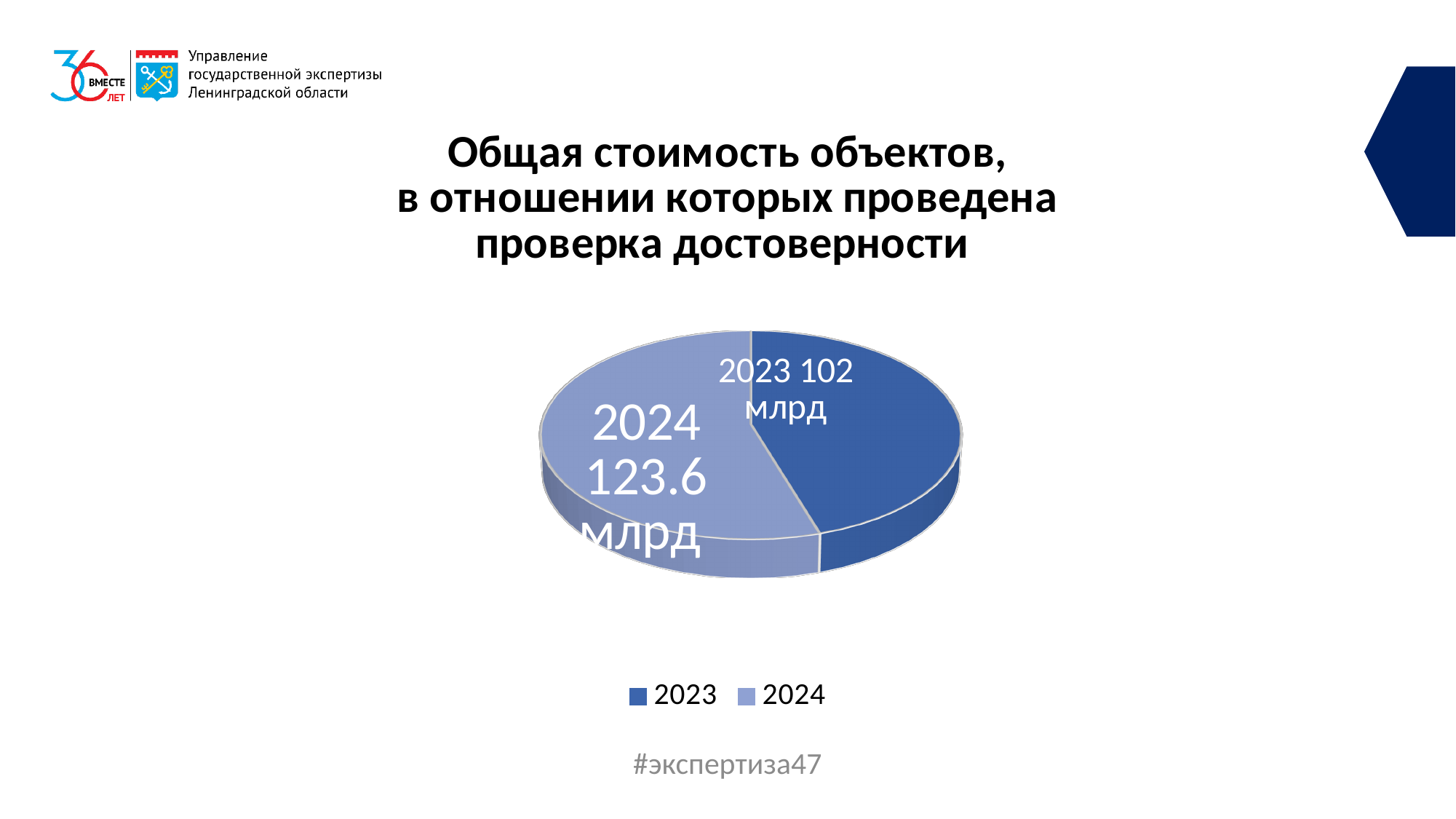
Which year has the larger slice in the pie chart? 2024 How many slices does the pie chart have? 2 Is the value for 2023 larger or smaller than the value for 2024? smaller What is the value for 2023 in the pie chart? 102 млрд What is the value for 2024 in the pie chart? 123.6 млрд By how much does the value for 2024 exceed the value for 2023? 21.6 млрд Which year has the smaller slice in the pie chart? 2023 Which year is shown in the darker blue colour in the pie chart? 2023 What is the combined value of the two slices in the pie chart? 225.6 млрд How many entries does the legend list? 2 What is the title of the chart on the slide? Общая стоимость объектов, в отношении которых проведена проверка достоверности What kind of chart is shown on the slide? pie chart